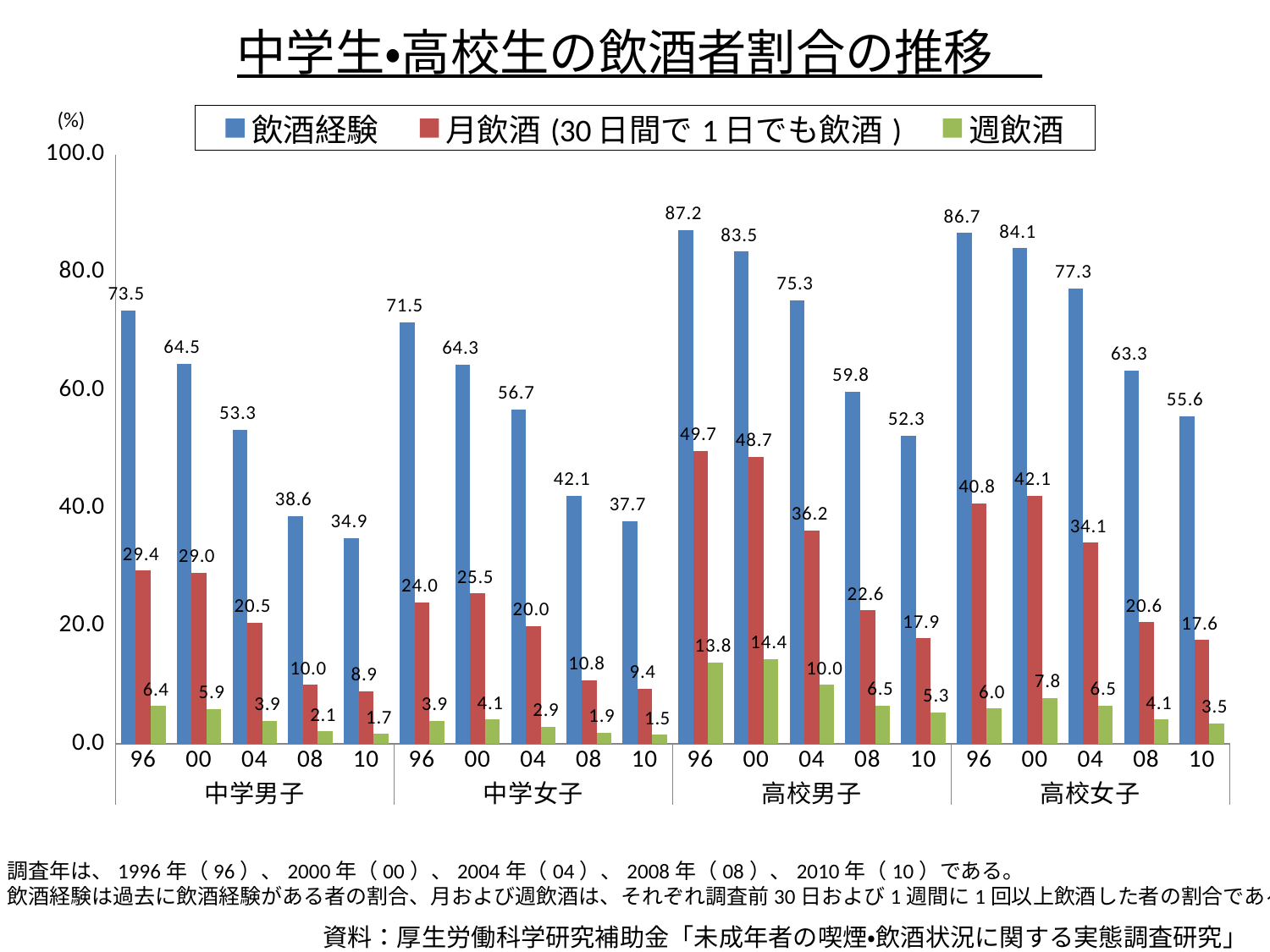
What is the difference between the 飲酒経験 values for 中学女子 in 96 and in 10? 33.8 Does the 飲酒経験 value for 中学男子 generally rise or fall from 96 to 10? fall What is the 飲酒経験 value for 中学男子 in 96? 73.5 What type of chart is shown on the slide? bar chart Which group and year has the lowest 週飲酒 value? 中学女子 10 How many year categories are shown within each group on the x axis? 5 What is the 週飲酒 value for 高校女子 in 04? 6.5 Which is larger, the 月飲酒 value for 高校男子 in 04 or for 高校女子 in 04? 高校男子 in 04 How many series does the legend list? 3 What colour are the 週飲酒 bars? green Which group and year has the highest 飲酒経験 value? 高校男子 96 What is the 月飲酒 value for 高校男子 in 00? 48.7